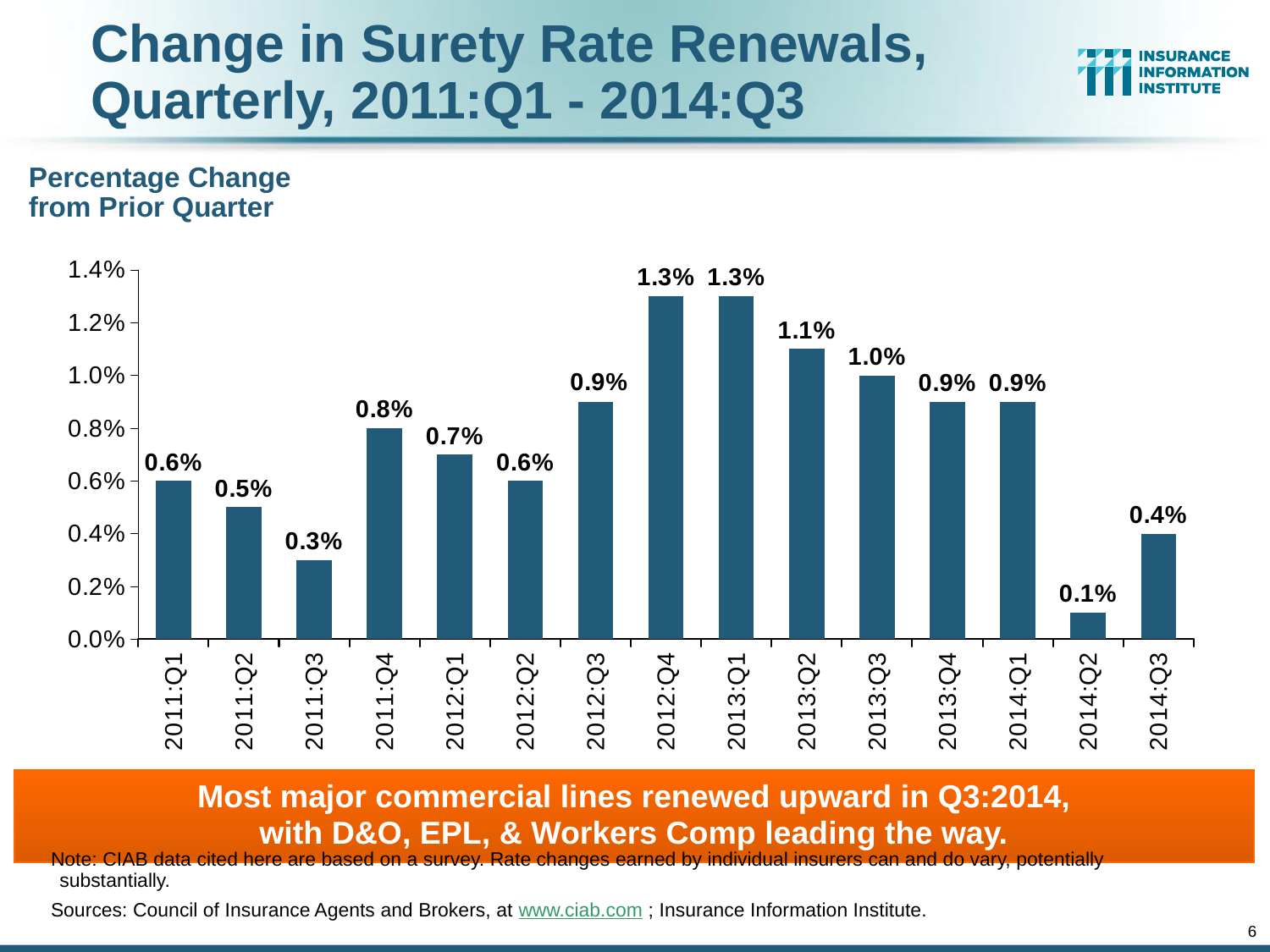
What is the value shown for 2011:Q3? 0.3% What is the value shown for 2013:Q3? 1.0% What is the difference between the values for 2013:Q2 and 2014:Q3? 0.7% What is the difference between the values for 2012:Q4 and 2011:Q3? 1.0% What kind of chart is shown on the slide? Bar chart Do the values rise or fall from 2013:Q1 to 2014:Q2? Fall What is the value shown for 2014:Q2? 0.1% What is the percentage change in surety rate renewals for 2012:Q4? 1.3% Which is larger, the value for 2011:Q4 or the value for 2012:Q2? 2011:Q4 Which quarter has the lowest percentage change? 2014:Q2 How many quarters are plotted on the chart? 15 What is the title of the chart on the slide? Change in Surety Rate Renewals, Quarterly, 2011:Q1 - 2014:Q3